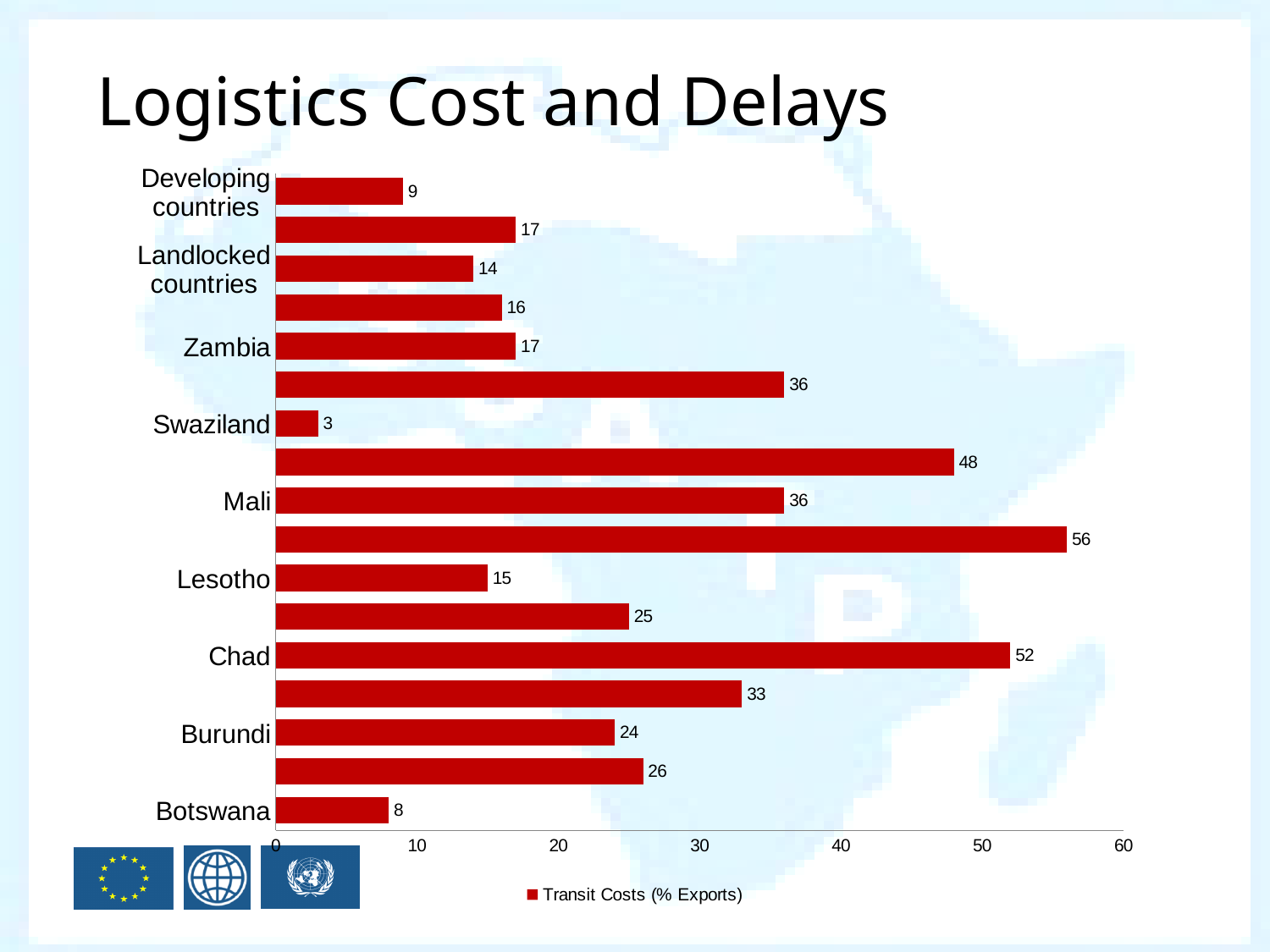
What is the value shown for Landlocked countries? 14 What is the transit cost value for Swaziland? 3 Is the value for Zambia greater or less than 20? less What series name does the legend show? Transit Costs (% Exports) What is the transit cost value for Botswana? 8 What is the value shown for Developing countries? 9 How many bars are plotted in the chart? 17 What is the difference between the values for Chad and Mali? 16 What is the transit cost value for Chad? 52 Which has a larger value, Burundi or Lesotho? Burundi Which labelled category has the lowest value? Swaziland What type of chart is shown on the slide? Bar chart